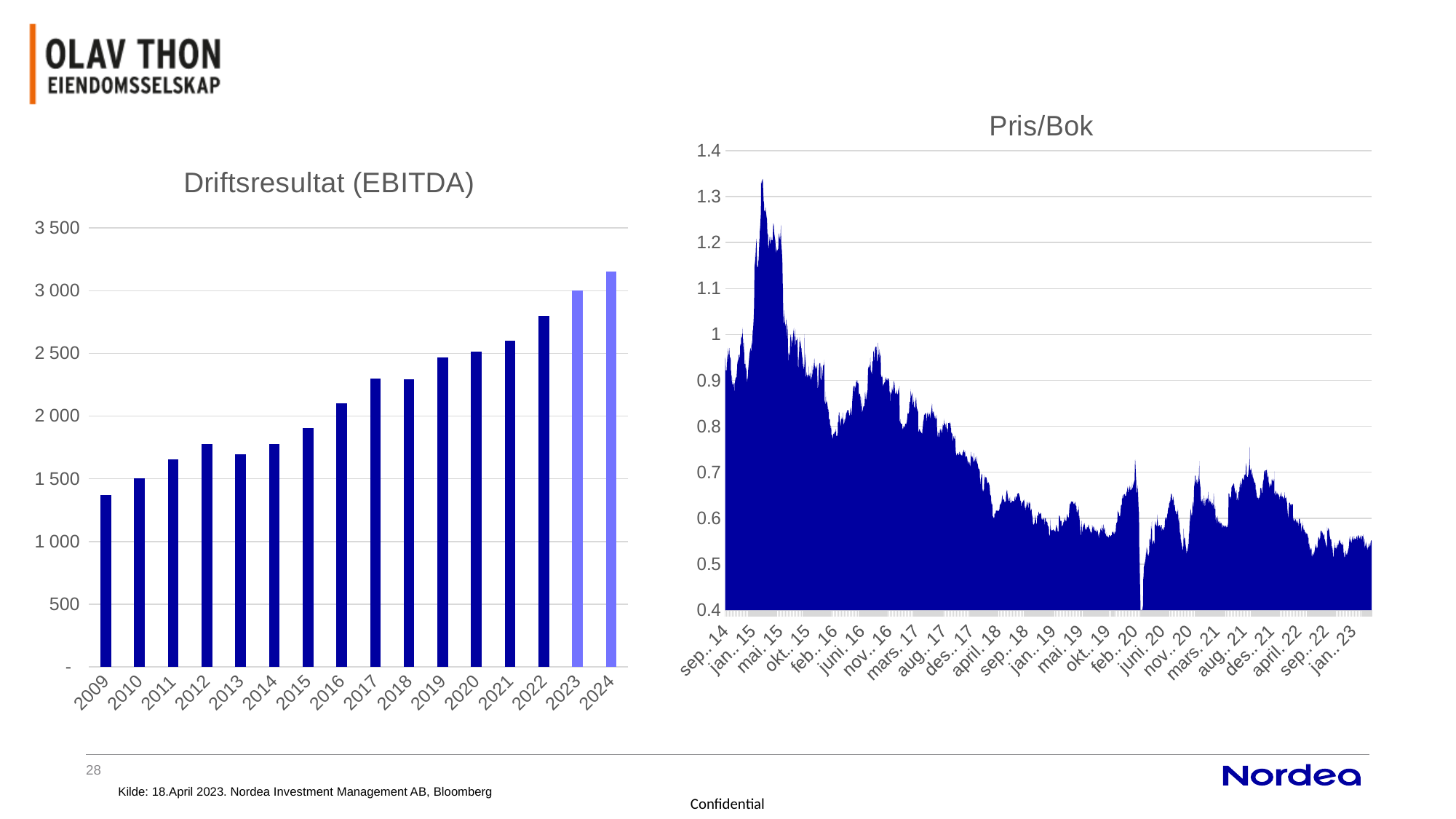
In the Driftsresultat (EBITDA) chart, which year has the lowest bar? 2009 In the Pris/Bok chart, is the value at the end of the series (jan. 23) greater or less than 0.6? less In the Driftsresultat (EBITDA) chart, which year has the highest bar? 2024 In the Driftsresultat (EBITDA) chart, which is larger, the value for 2021 or the value for 2022? 2022 In the Driftsresultat (EBITDA) chart, is the value for 2009 greater or less than 1 500? less What kind of chart is the Driftsresultat (EBITDA) chart? bar chart In the Driftsresultat (EBITDA) chart, is the value for 2016 greater or less than 2 000? greater In the Driftsresultat (EBITDA) chart, do the values generally rise or fall from 2009 to 2024? rise In the Driftsresultat (EBITDA) chart, which two years are drawn in a lighter shade of blue than the others? 2023 and 2024 How many years are shown on the x axis of the Driftsresultat (EBITDA) chart? 16